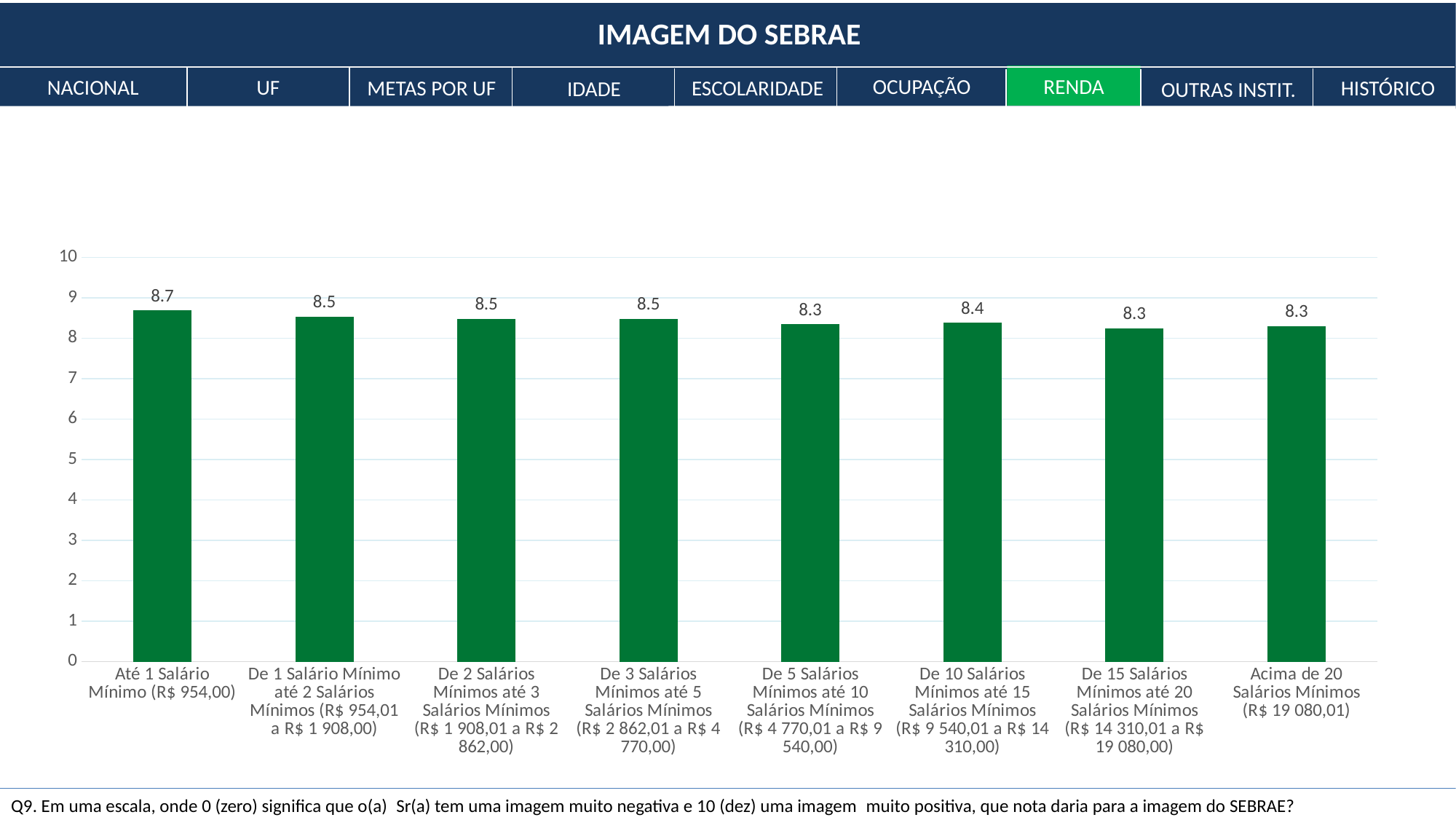
How many income categories are shown in the chart? 8 What is the value for the 'Até 1 Salário Mínimo (R$ 954,00)' category? 8.7 What is the value for the 'De 10 Salários Mínimos até 15 Salários Mínimos' category? 8.4 What is the difference between the value for 'Até 1 Salário Mínimo' and the value for 'Acima de 20 Salários Mínimos'? 0.4 Is the value for 'De 5 Salários Mínimos até 10 Salários Mínimos' greater or less than 8? greater What kind of chart is shown on the slide? Bar chart Which income category has the highest value? Até 1 Salário Mínimo (R$ 954,00) What is the difference between the value for 'De 1 Salário Mínimo até 2 Salários Mínimos' and the value for 'De 5 Salários Mínimos até 10 Salários Mínimos'? 0.2 What is the value for the 'Acima de 20 Salários Mínimos (R$ 19 080,01)' category? 8.3 Which is larger: the value for 'Até 1 Salário Mínimo' or the value for 'De 15 Salários Mínimos até 20 Salários Mínimos'? Até 1 Salário Mínimo What is the value for the 'De 3 Salários Mínimos até 5 Salários Mínimos' category? 8.5 What is the title shown at the top of the slide? IMAGEM DO SEBRAE